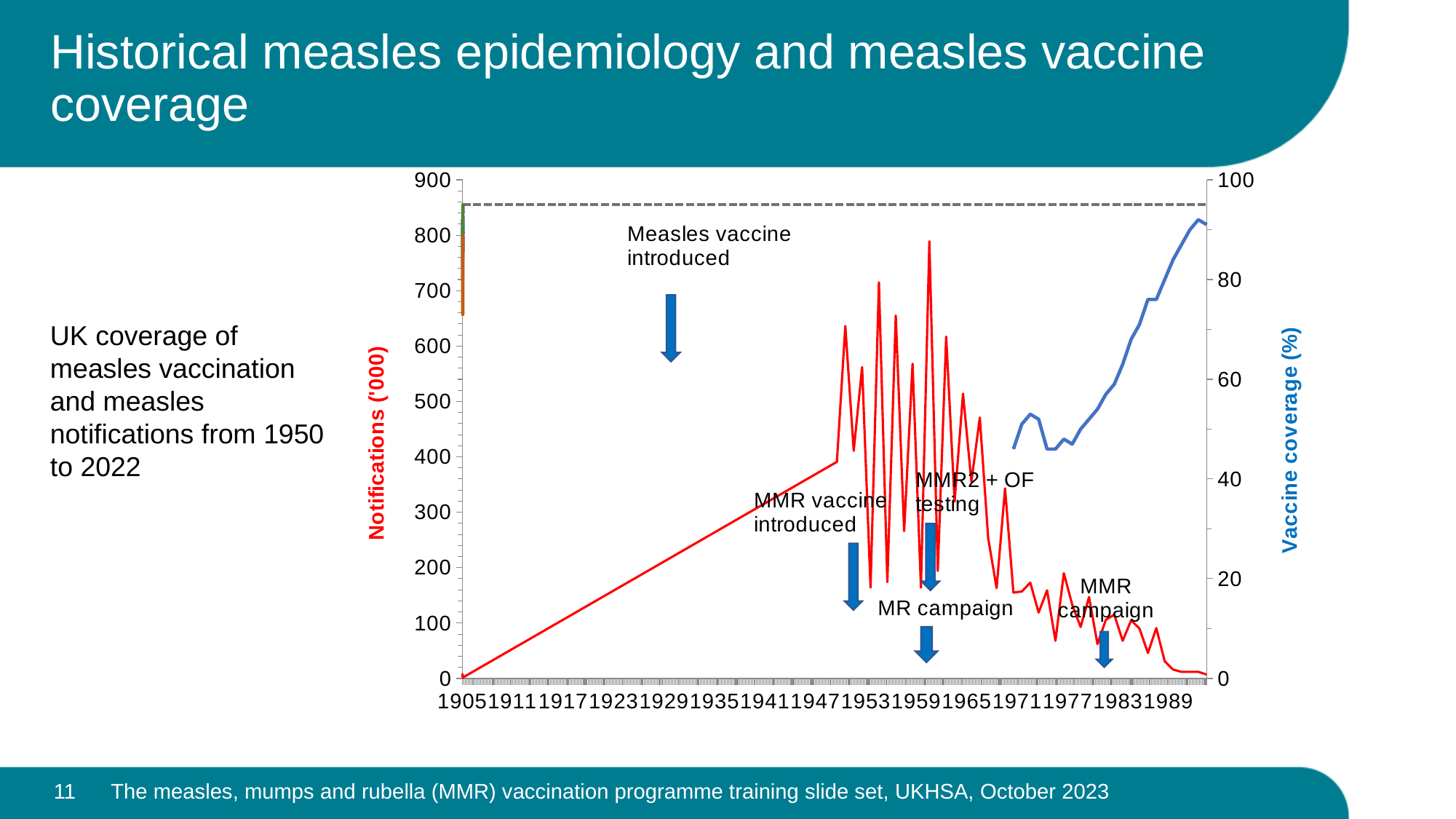
Does the blue vaccine coverage line generally rise or fall from left to right? rise What is the maximum value shown on the right Vaccine coverage axis? 100 Is the vaccine coverage value at the left-hand start of the blue line greater or less than 60? less What is the title of the left vertical axis? Notifications ('000) Which event annotation is placed furthest to the left on the chart? Measles vaccine introduced Is the vaccine coverage value at the right-hand end of the blue line greater or less than 80? greater What kind of chart is shown on the slide? Line chart What is the maximum value shown on the left Notifications axis? 900 Does the red notifications line rise or fall between 1971 and the right-hand end of the chart? fall What is the title of the right vertical axis? Vaccine coverage (%) Is the highest value reached by the red notifications line greater or less than 700? greater